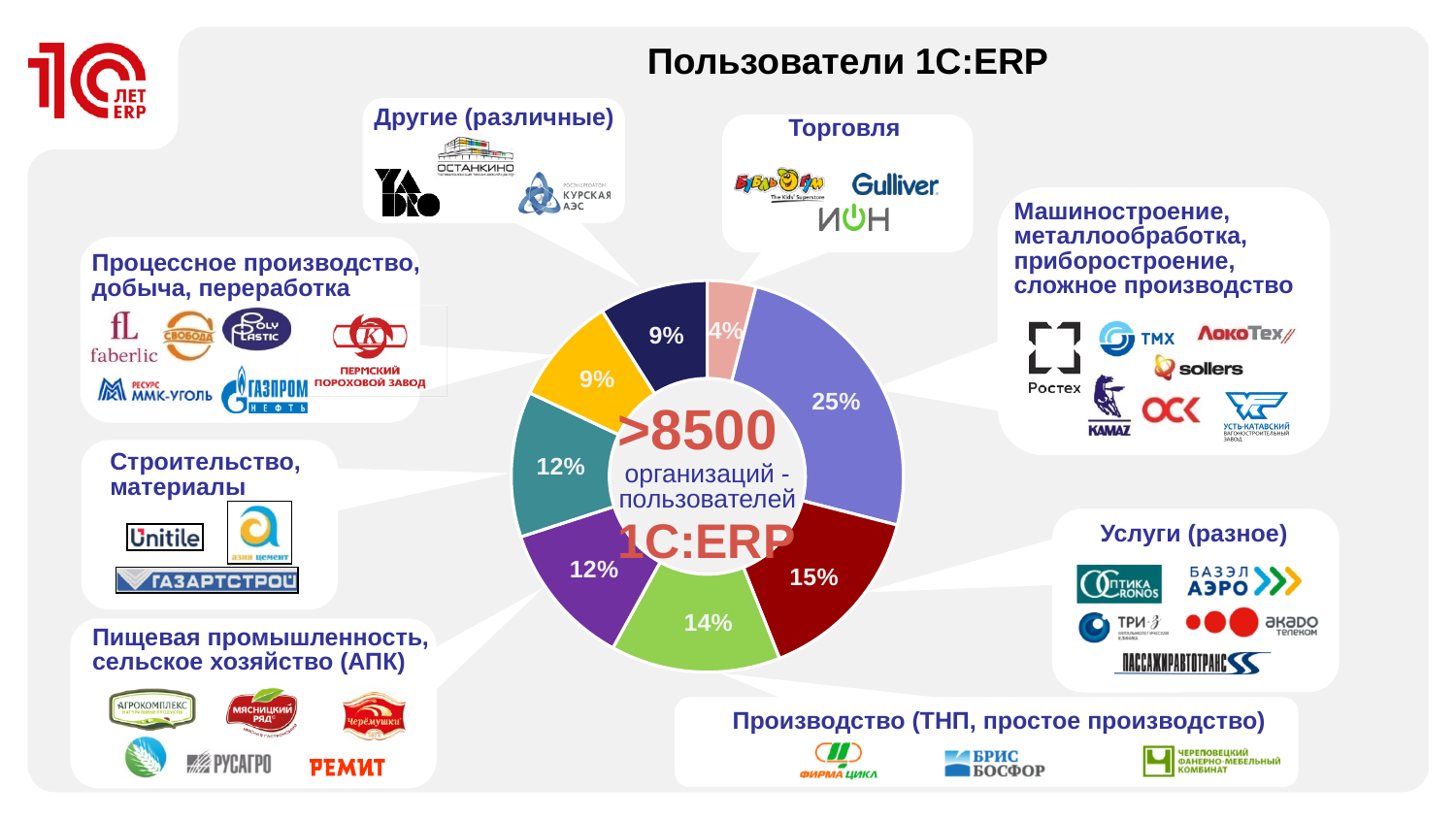
Which industry segment has the largest share in the chart? Машиностроение, металлообработка, приборостроение, сложное производство What is the title of the slide? Пользователи 1С:ERP What percentage is shown for the 'Услуги (разное)' segment? 15% What number of organisations is stated in the centre of the chart? >8500 What share of 1C:ERP users belongs to the segment 'Машиностроение, металлообработка, приборостроение, сложное производство'? 25% What type of chart is shown on the slide? Donut (pie) chart Which industry segment has the smallest share in the chart? Торговля What share of the donut chart is labelled for 'Торговля'? 4% How many segments does the donut chart have? 8 Which segment is larger: 'Услуги (разное)' or 'Производство (ТНП, простое производство)'? Услуги (разное) What percentage is shown for the 'Производство (ТНП, простое производство)' segment? 14% By how many percentage points does the 'Машиностроение' segment exceed the 'Услуги (разное)' segment? 10 percentage points